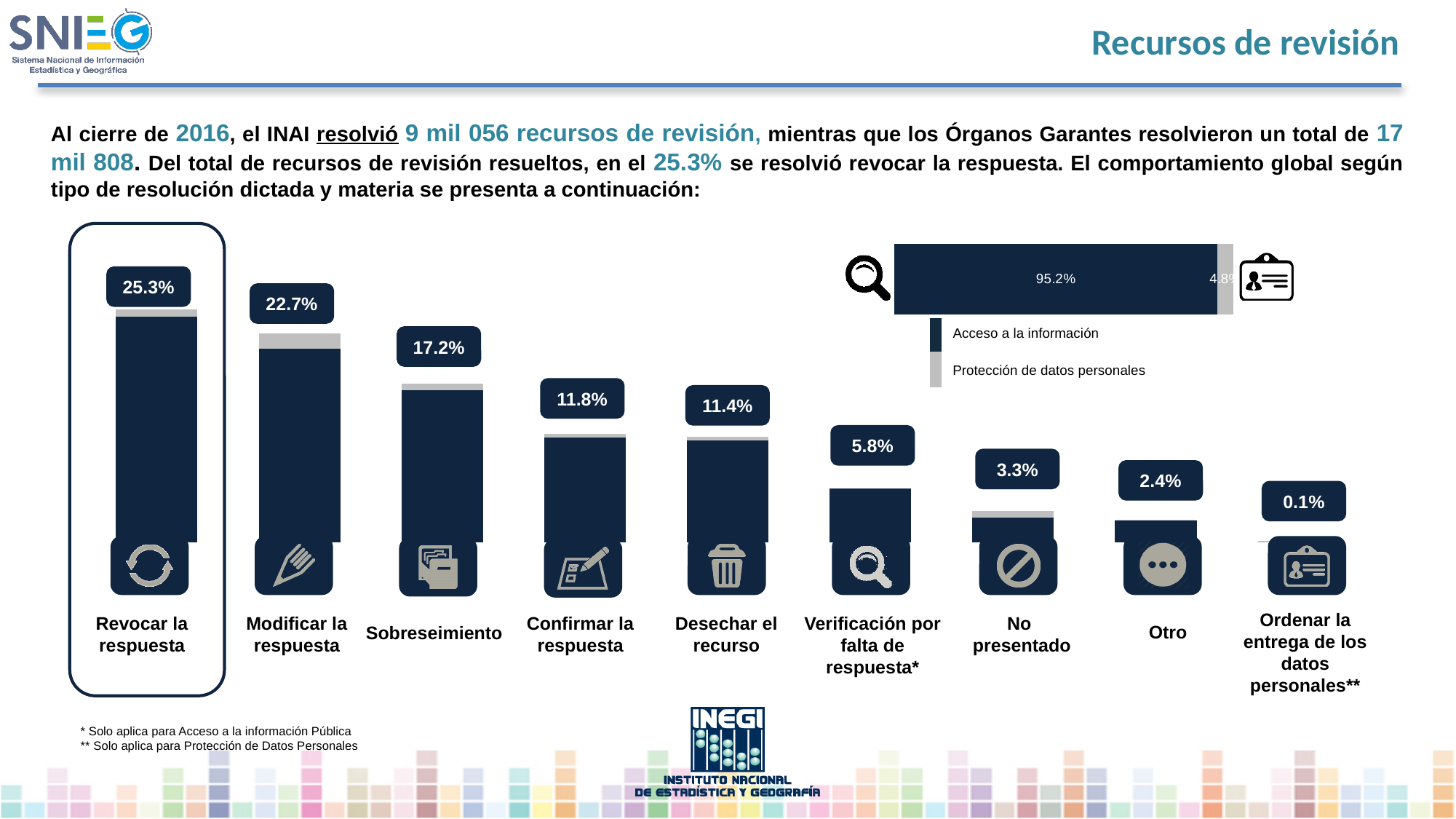
In the main bar chart, what is the value for No presentado? 3.3% In the main bar chart, which is larger: Confirmar la respuesta or Desechar el recurso? Confirmar la respuesta In the small stacked bar at the top right, what is the value for Acceso a la información? 95.2% In the main bar chart, what is the value for Revocar la respuesta? 25.3% In the main bar chart, which category has the lowest value? Ordenar la entrega de los datos personales** In the main bar chart, what is the value for Desechar el recurso? 11.4% How many series does the legend of the small stacked bar at the top right list? 2 In the main bar chart, what is the value for Sobreseimiento? 17.2% What kind of chart is the main chart on the slide? Bar chart How many categories does the main bar chart show? 9 In the main bar chart, what is the difference between Revocar la respuesta and Modificar la respuesta? 2.6% In the main bar chart, which category has the highest value? Revocar la respuesta